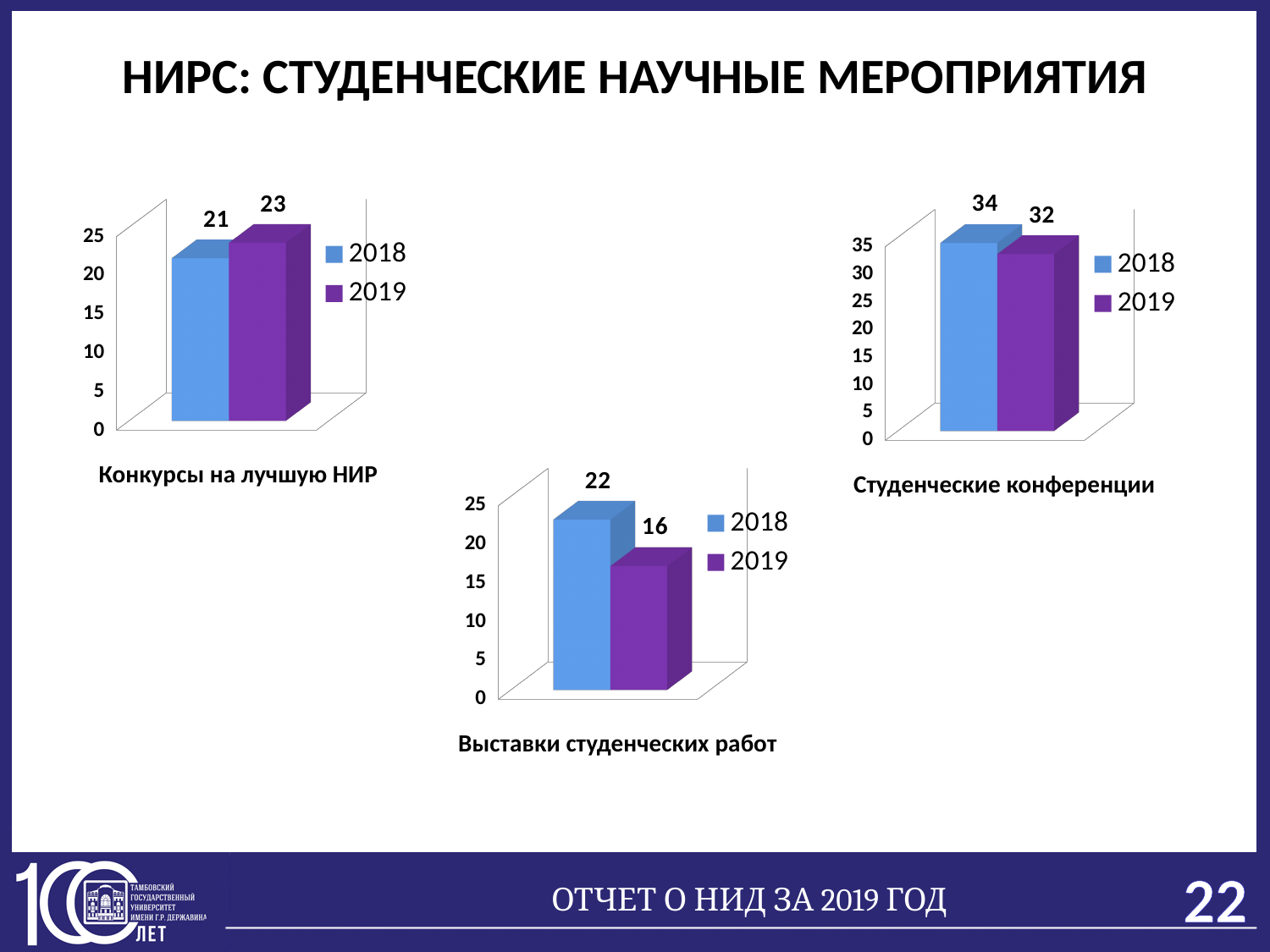
In the chart titled 'Студенческие конференции', is the value for 2019 greater or less than 30? greater In the chart titled 'Конкурсы на лучшую НИР', is the value for 2019 larger or smaller than the value for 2018? larger In the chart titled 'Студенческие конференции', what is the difference between the 2018 and 2019 values? 2 In the chart titled 'Выставки студенческих работ', which year has the higher value? 2018 In the chart titled 'Выставки студенческих работ', what is the value for 2019? 16 In the chart titled 'Конкурсы на лучшую НИР', what is the value for 2018? 21 In the chart titled 'Выставки студенческих работ', what is the difference between the 2018 and 2019 values? 6 In the chart titled 'Конкурсы на лучшую НИР', what is the value for 2019? 23 What kind of chart is the chart titled 'Конкурсы на лучшую НИР'? bar chart How many series does the legend list in the chart titled 'Выставки студенческих работ'? 2 In the chart titled 'Студенческие конференции', which year has the lower value? 2019 In the chart titled 'Студенческие конференции', what is the value for 2018? 34